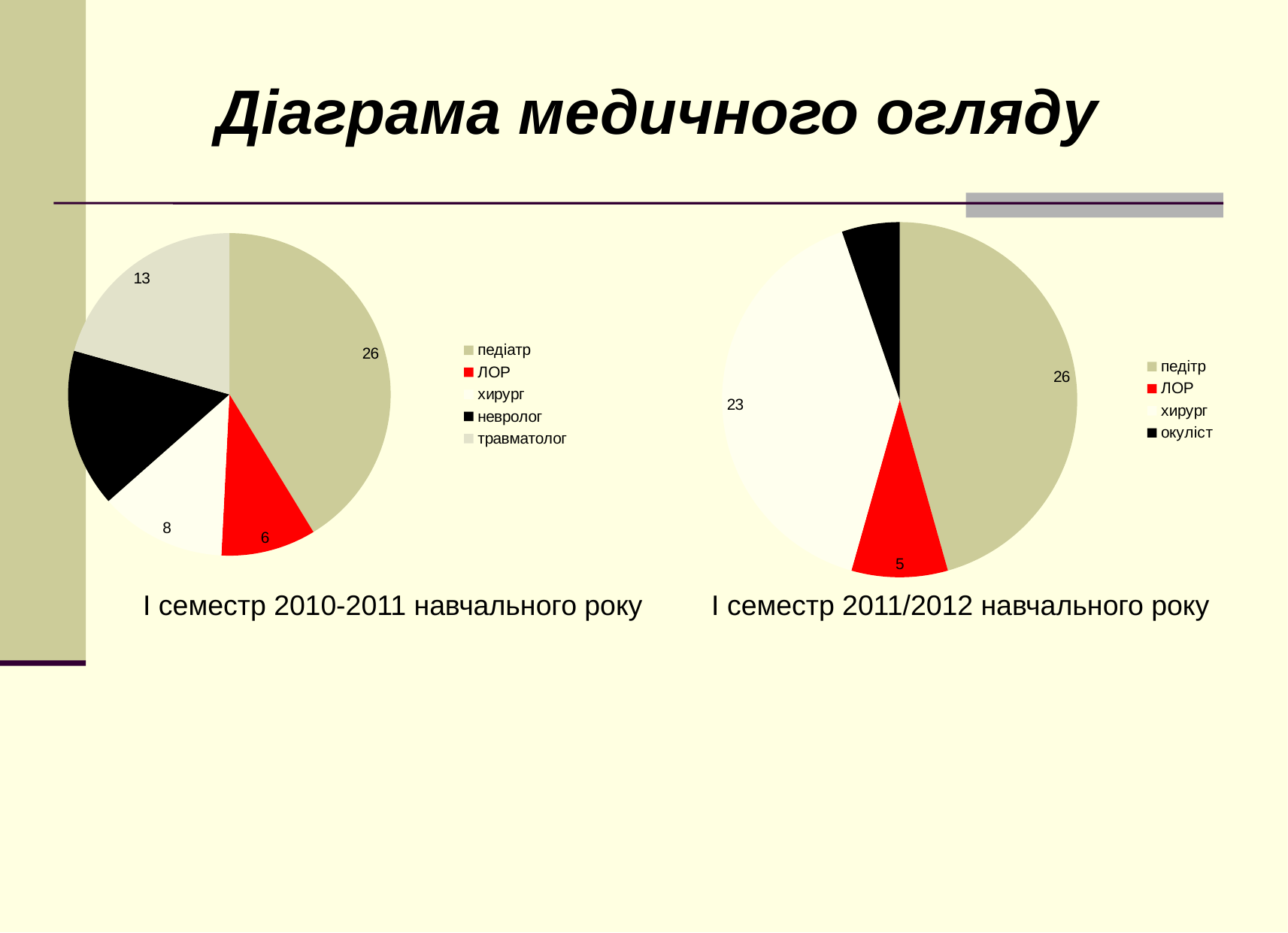
In the left chart (І семестр 2010-2011 навчального року), which category has the smallest slice? ЛОР In the right chart (І семестр 2011/2012 навчального року), what is the value for ЛОР? 5 In the left chart (І семестр 2010-2011 навчального року), what is the value for травматолог? 13 In the left chart (І семестр 2010-2011 навчального року), what is the value for педіатр? 26 In the left chart (І семестр 2010-2011 навчального року), which category has the largest slice? педіатр How many categories does the legend of the left chart (І семестр 2010-2011 навчального року) list? 5 How many categories does the legend of the right chart (І семестр 2011/2012 навчального року) list? 4 In the right chart (І семестр 2011/2012 навчального року), what is the value for хирург? 23 What type of chart is used on the left for І семестр 2010-2011 навчального року? pie chart In the right chart (І семестр 2011/2012 навчального року), which is larger, педітр or хирург? педітр In the left chart (І семестр 2010-2011 навчального року), what is the value for ЛОР? 6 In the left chart (І семестр 2010-2011 навчального року), what is the difference between педіатр and травматолог? 13